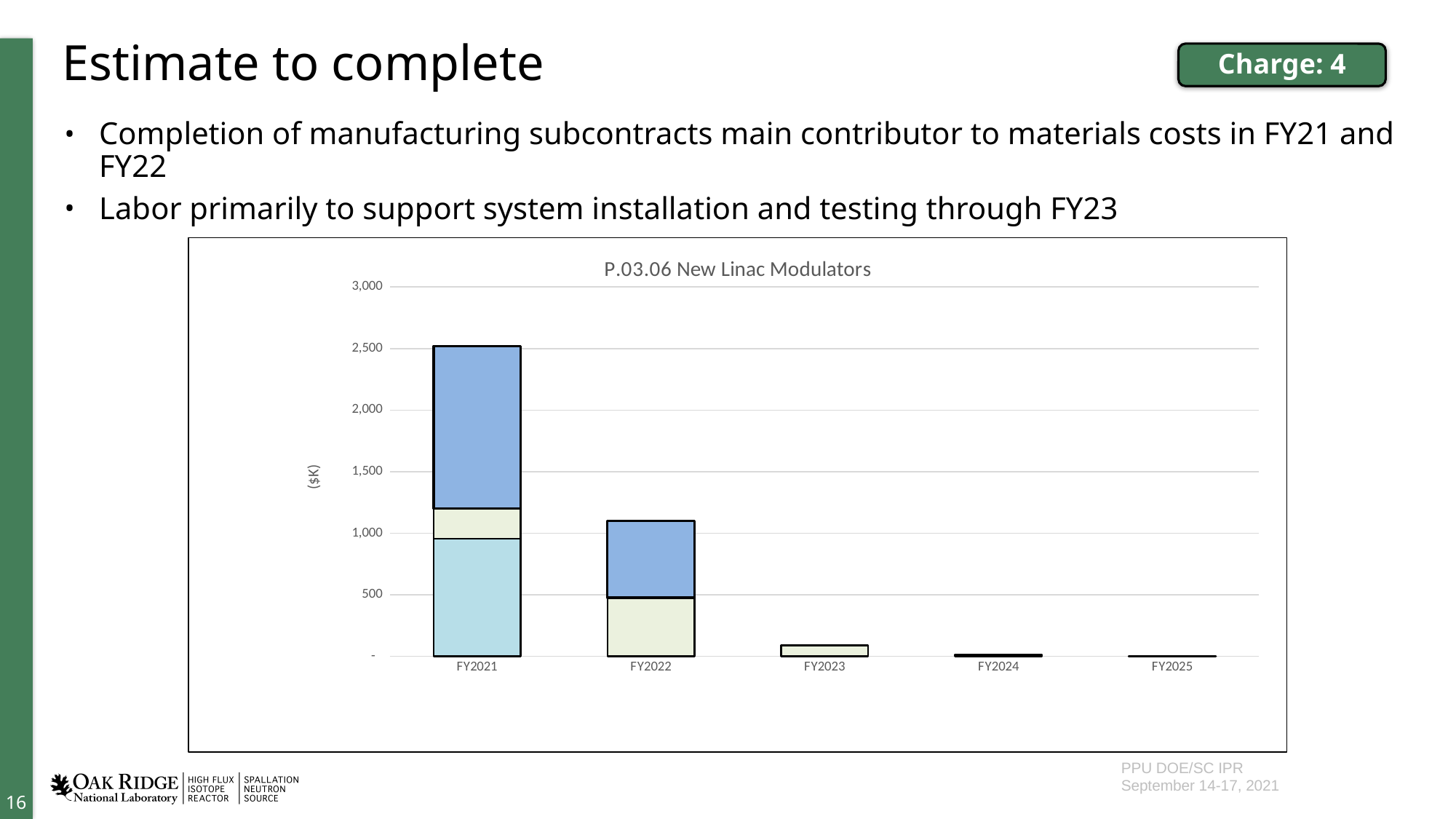
Is the total value for FY2022 greater or less than 1,500? less What is the title of the chart? P.03.06 New Linac Modulators What is the highest value shown on the vertical axis of the chart? 3,000 What kind of chart is shown on the slide? stacked bar chart Is the total value for FY2023 greater or less than 500? less Which has a larger total bar, FY2022 or FY2023? FY2022 Do the total bar values rise or fall from FY2021 to FY2025? fall Is the total value for FY2021 greater or less than 2,000? greater How many fiscal years are shown on the x axis of the chart? 5 Which has a larger total bar, FY2021 or FY2022? FY2021 Which fiscal year has the highest total bar in the chart? FY2021 What is the label on the vertical axis of the chart? ($K)